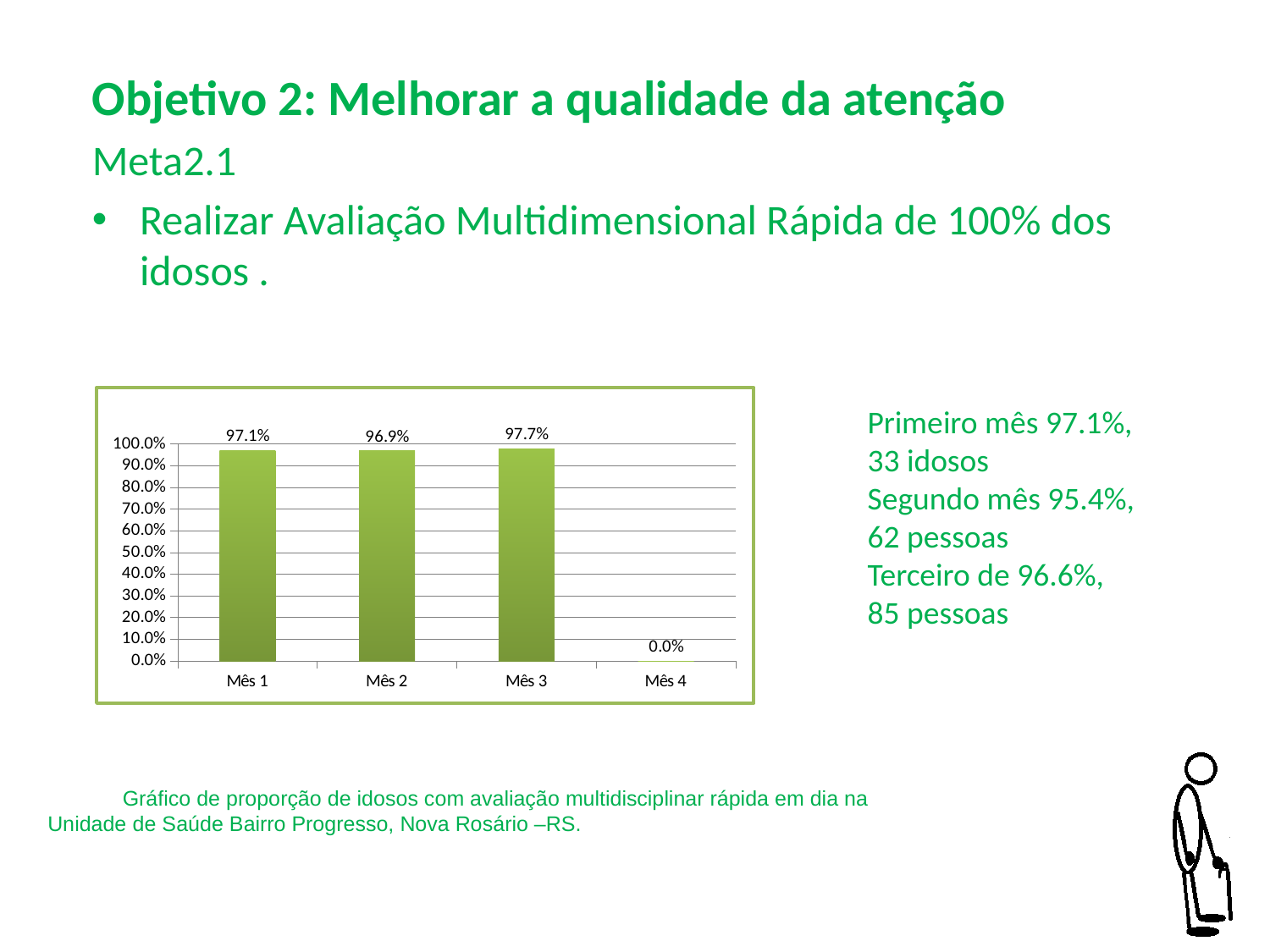
What colour are the bars in the chart? green What is the value for Mês 4? 0.0% How many months are shown on the x axis? 4 What is the difference between the values for Mês 3 and Mês 1? 0.6 percentage points What is the value for Mês 2? 96.9% Is the value for Mês 2 greater or less than 90.0%? greater What kind of chart is shown on the slide? bar chart What is the value for Mês 1? 97.1% What is the value for Mês 3? 97.7% Which month has the highest value? Mês 3 Which is larger, the value for Mês 1 or the value for Mês 2? Mês 1 Which month has the lowest value? Mês 4